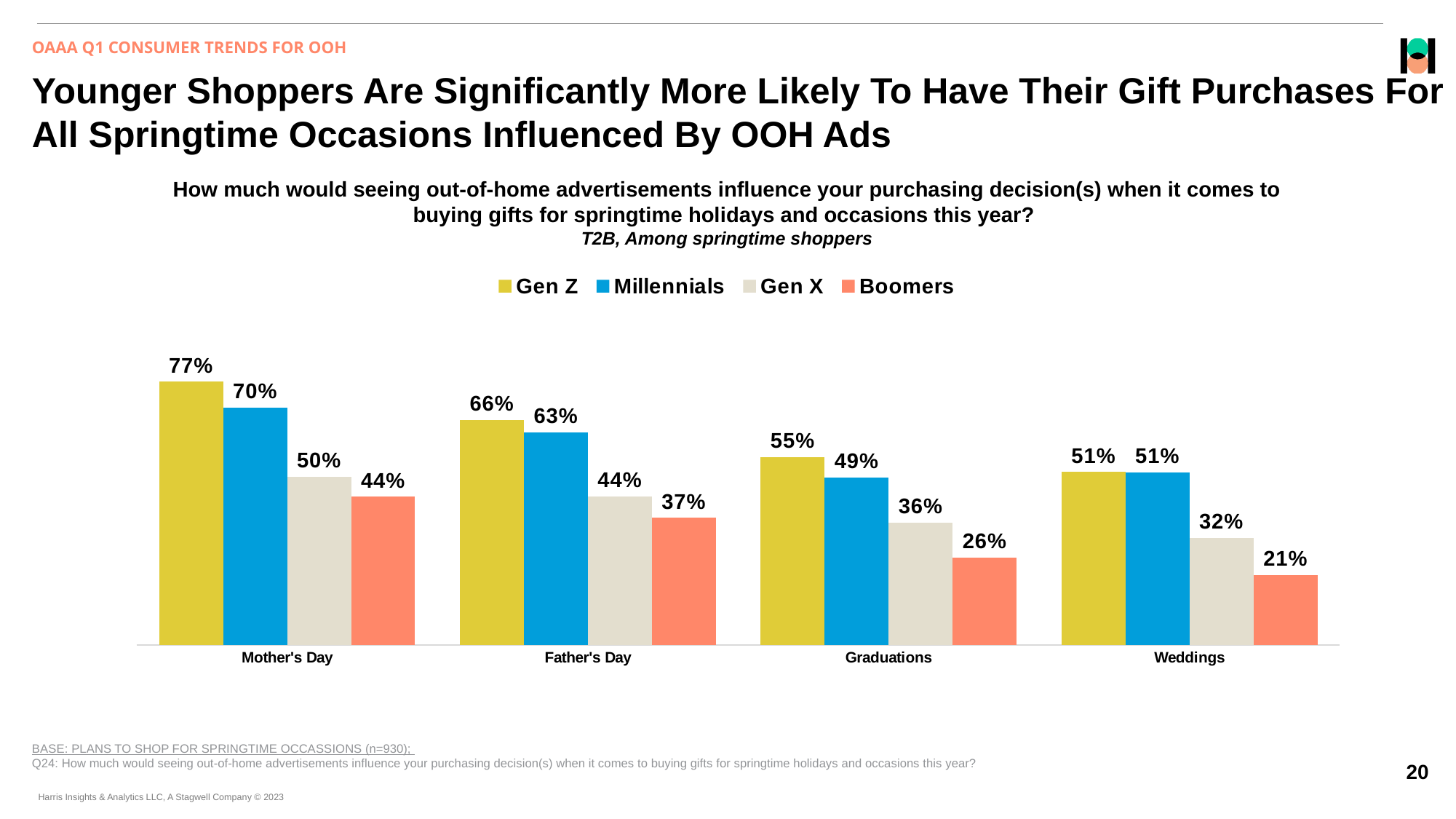
How many occasions are shown on the x axis? 4 Which is larger for Father's Day: the Gen X value or the Boomers value? Gen X Which occasion has the highest value for Gen Z? Mother's Day Which occasion has the lowest value for Boomers? Weddings What is the value for Boomers for Weddings? 21% What kind of chart is shown on the slide? Bar chart What is the value for Gen Z for Mother's Day? 77% What is the difference between the Gen Z and Boomers values for Mother's Day? 33% What is the value for Gen X for Graduations? 36% What is the value for Millennials for Father's Day? 63% How many series does the legend list? 4 What is the difference between the Millennials and Gen X values for Graduations? 13%